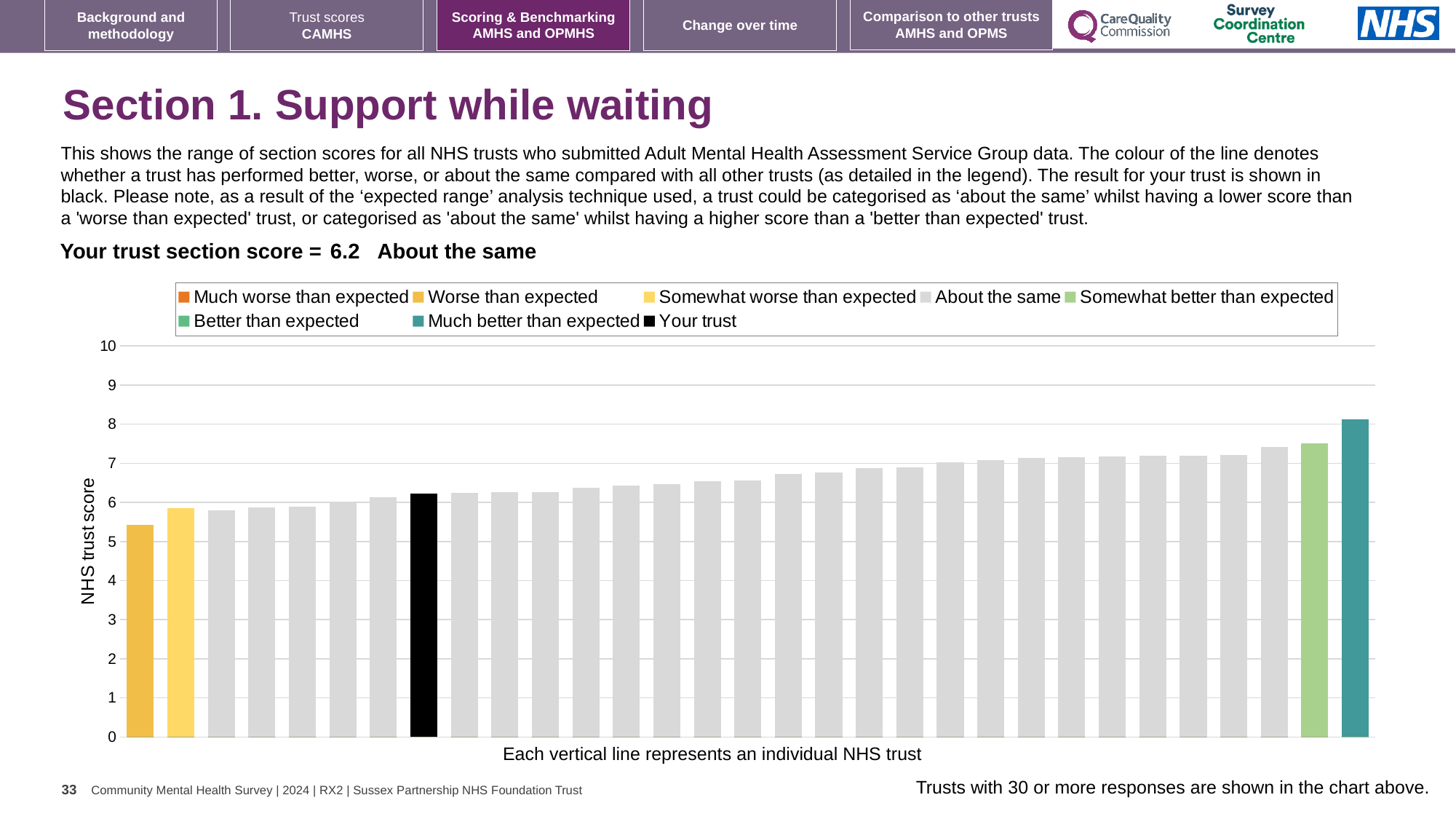
What is the section score for your trust shown on the slide? 6.2 What is the label on the vertical axis of the chart? NHS trust score Is the value for your trust (the black bar) greater or less than 5? greater What is the highest tick value shown on the vertical axis? 10 Which legend category does the tallest bar (the teal bar on the far right) belong to? Much better than expected How many entries does the chart legend list? 8 What kind of chart is shown on the slide? bar chart Which category is your trust's section score placed in? About the same Do the bar values rise or fall from left to right along the x axis? rise Which legend category does the shortest bar (the gold bar on the far left) belong to? Worse than expected Is the value of the lowest bar in the chart greater or less than 6? less Is the value of the highest bar in the chart greater or less than 7? greater